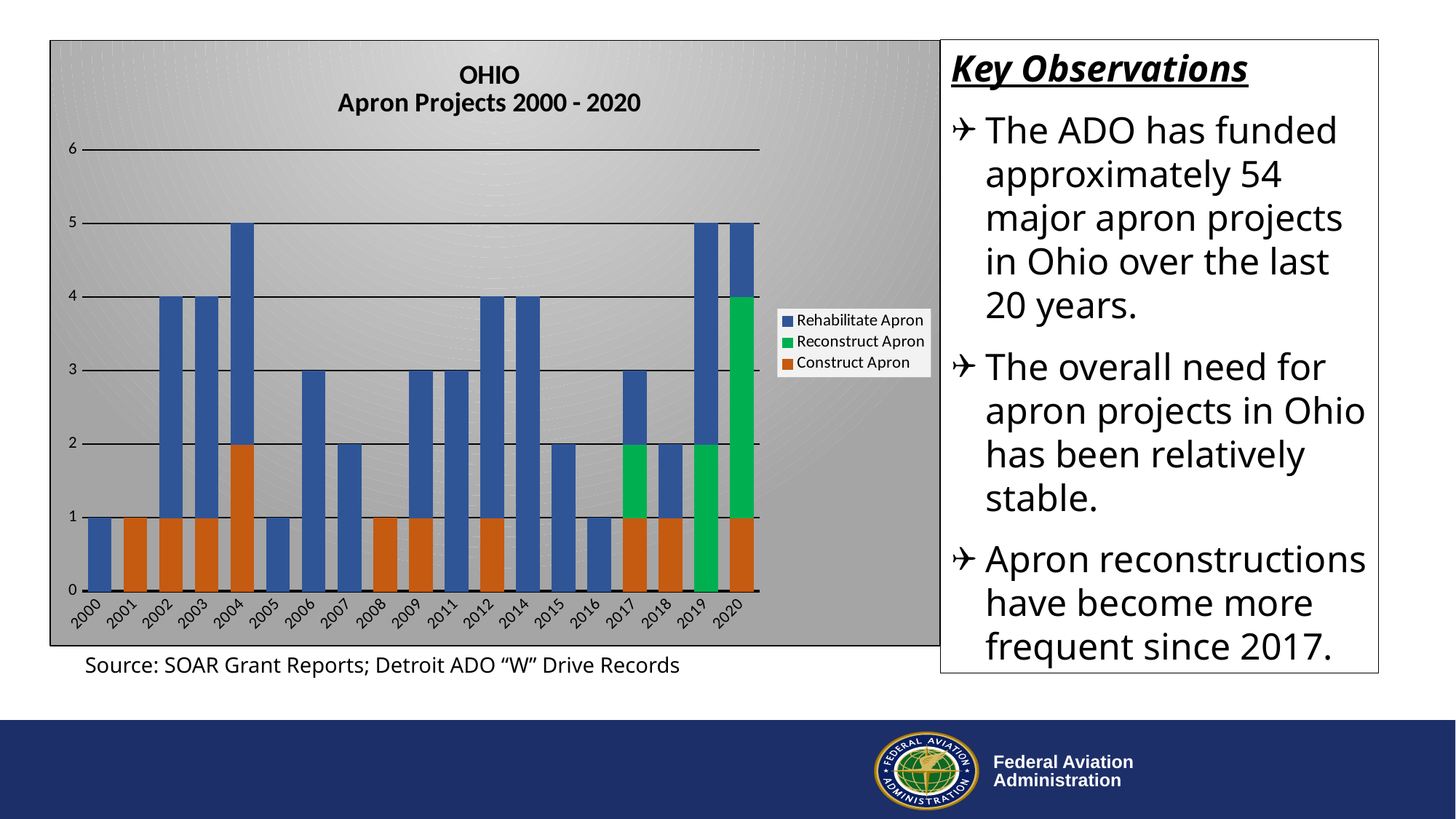
Which year has the larger total of apron projects, 2002 or 2007? 2002 How many Reconstruct Apron projects are shown for 2020? 3 What is the title of the chart? OHIO Apron Projects 2000 - 2020 What is the difference between the total projects in 2014 and the total projects in 2015? 2 Which colour represents Reconstruct Apron in the legend? Green How many Rehabilitate Apron projects are shown for 2014? 4 What is the total number of apron projects in 2020? 5 How many Construct Apron projects are shown for 2004? 2 How many years are shown along the x axis? 19 What is the total number of apron projects in 2004? 5 What kind of chart is shown on the slide? Stacked bar chart How many series does the legend list? 3